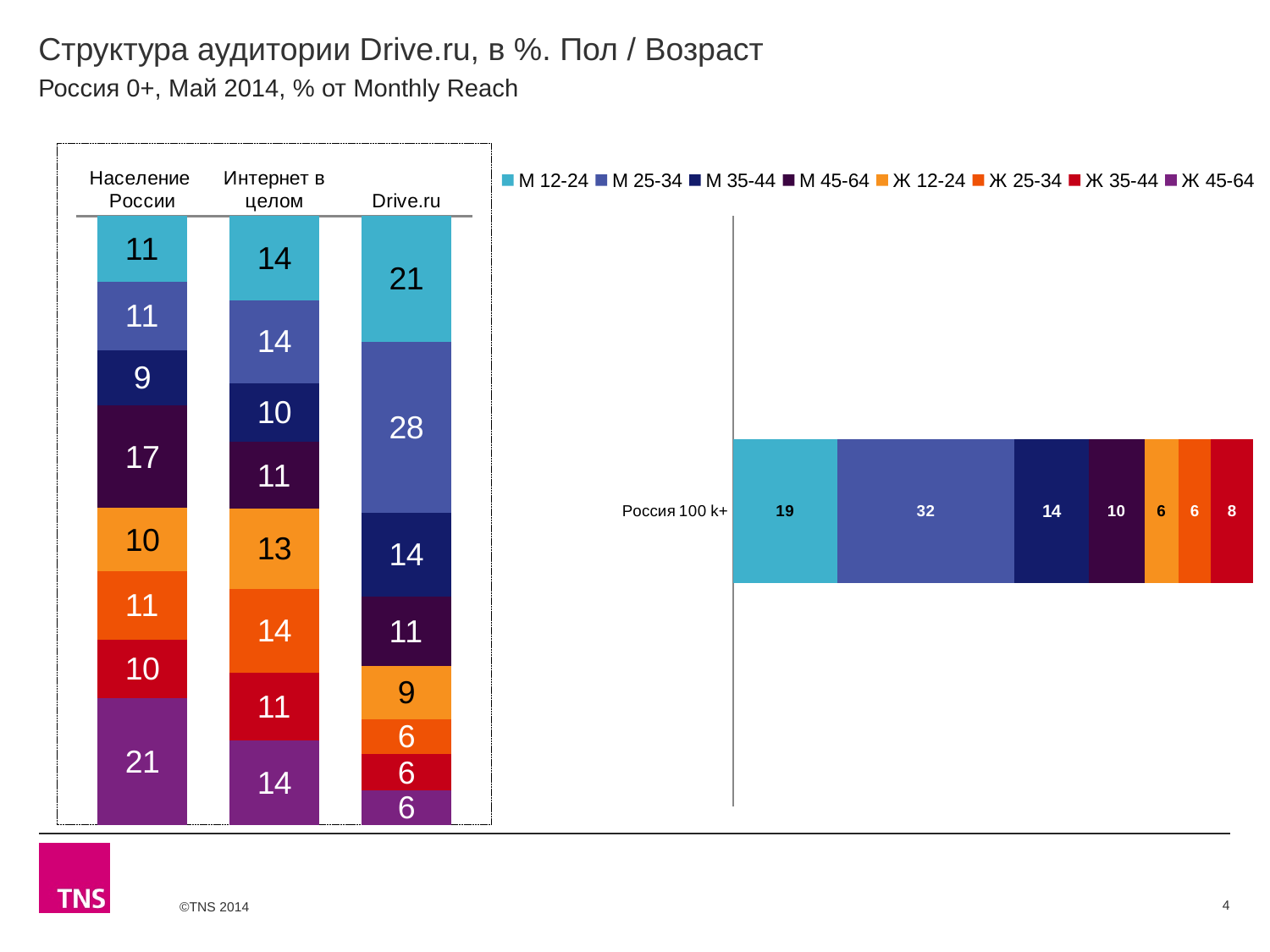
In the left chart, what is the value of the М 45-64 segment for Интернет в целом? 11 In the left chart, which segment of the Drive.ru bar is the largest? М 25-34 In the left chart, which segment of the Население России bar is the smallest? М 35-44 In the left chart, what is the value of the М 25-34 segment for Drive.ru? 28 In the left chart, which is larger: the Ж 45-64 value for Население России or for Drive.ru? Население России What kind of chart is the right chart? Stacked bar chart In the right chart, what is the value of the М 25-34 segment for Россия 100 k+? 32 How many bars does the left chart show? 3 How many series does the legend list? 8 In the left chart, what is the value of the Ж 45-64 segment for Население России? 21 In the right chart, what is the label of the single bar? Россия 100 k+ In the left chart, what is the difference between the М 12-24 values for Drive.ru and Население России? 10